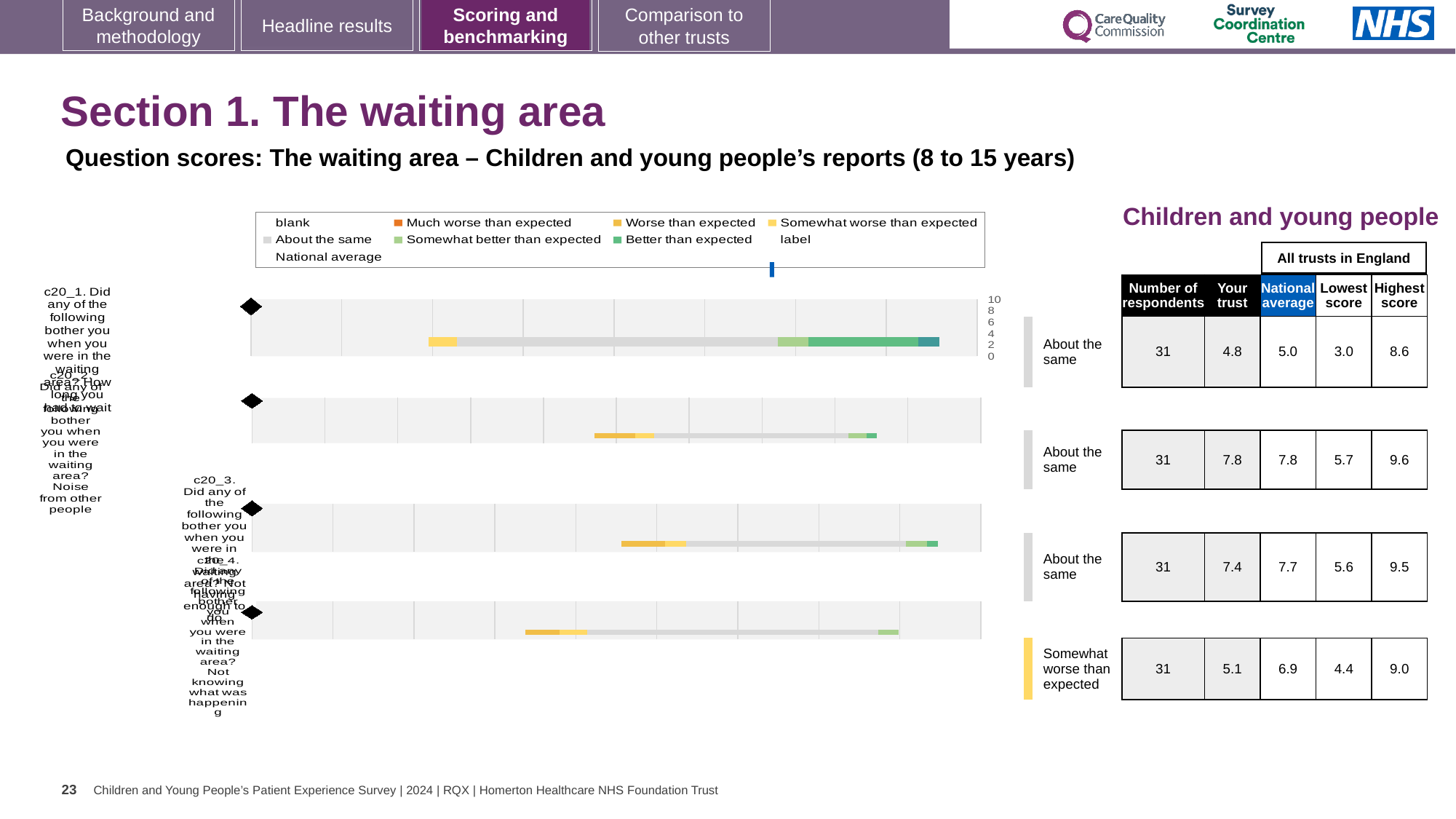
For the first question row (c20_1), what is the difference between the highest score and the lowest score? 5.6 What benchmark category is shown for the fourth question row (c20_4)? Somewhat worse than expected What kind of chart is used to show the question scores on this slide? bar chart Which question row has the highest 'Your trust' score in the table? the second row (c20_2), 7.8 In the table, what is the highest score for the third question row (c20_3)? 9.5 How many question rows (bars) are plotted in the chart? 4 For the fourth question row (c20_4), which is larger: the 'Your trust' score or the national average? National average In the table, what is the national average for the second question row (c20_2)? 7.8 How many respondents are listed for each question row in the table? 31 Which question row has the lowest 'Your trust' score in the table? the first row (c20_1), 4.8 In the table, what is the lowest score for the fourth question row (c20_4)? 4.4 In the table, what is the 'Your trust' score for the first question row (c20_1)? 4.8